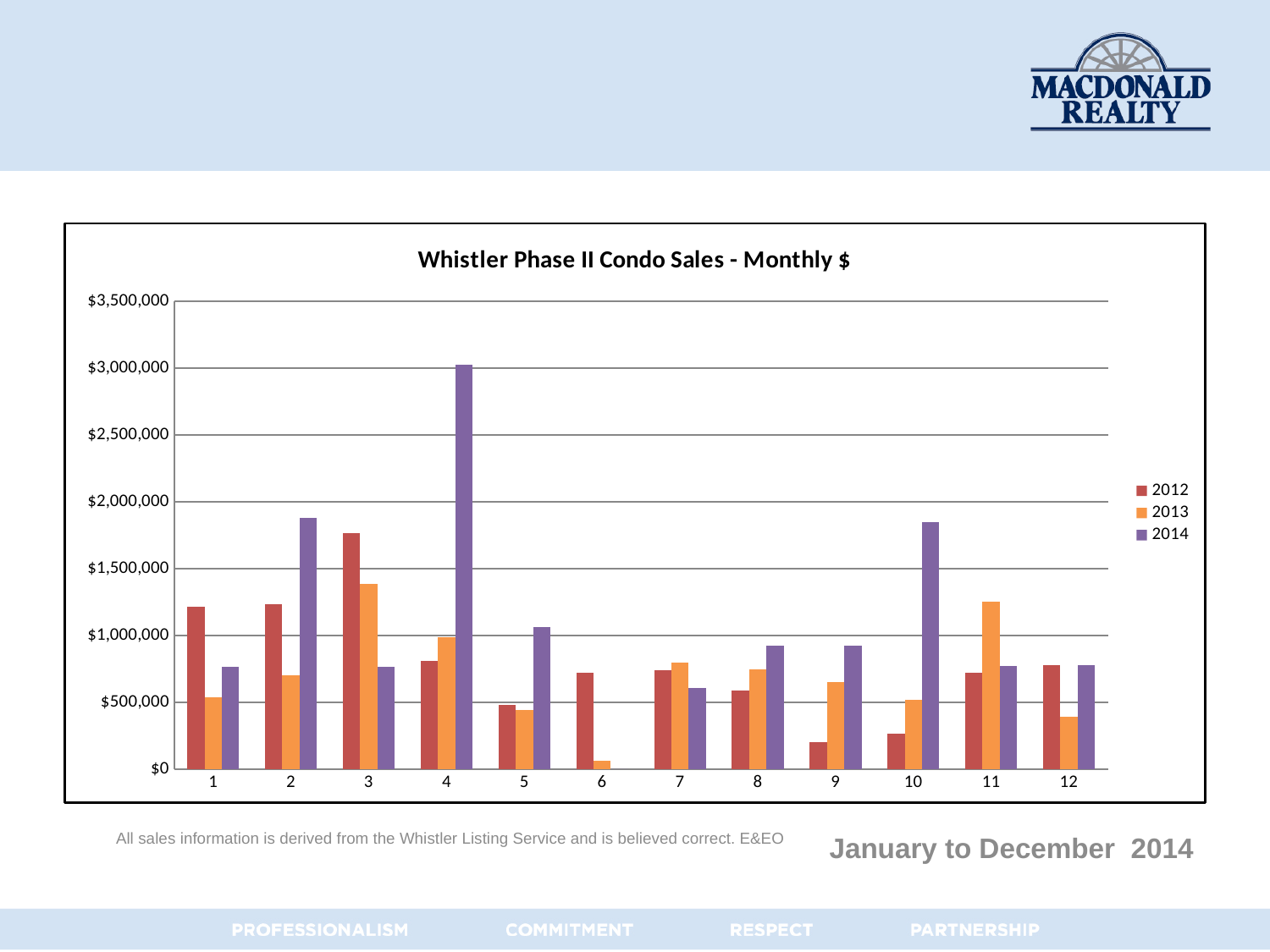
In month 11, which series has the larger value, 2012 or 2013? 2013 In month 1, which series has the larger value, 2012 or 2013? 2012 What is the title of the chart? Whistler Phase II Condo Sales - Monthly $ Which month has the lowest 2012 value? 9 Is the 2014 value for month 4 greater or less than $2,500,000? greater Is the 2012 value for month 9 greater or less than $500,000? less Which month has the highest 2012 value? 3 How many series does the legend list? 3 Which month has the highest 2014 value? 4 What kind of chart is shown on the slide? Bar chart How many months (categories) are shown on the x axis? 12 Is the 2012 value for month 3 greater or less than $1,500,000? greater